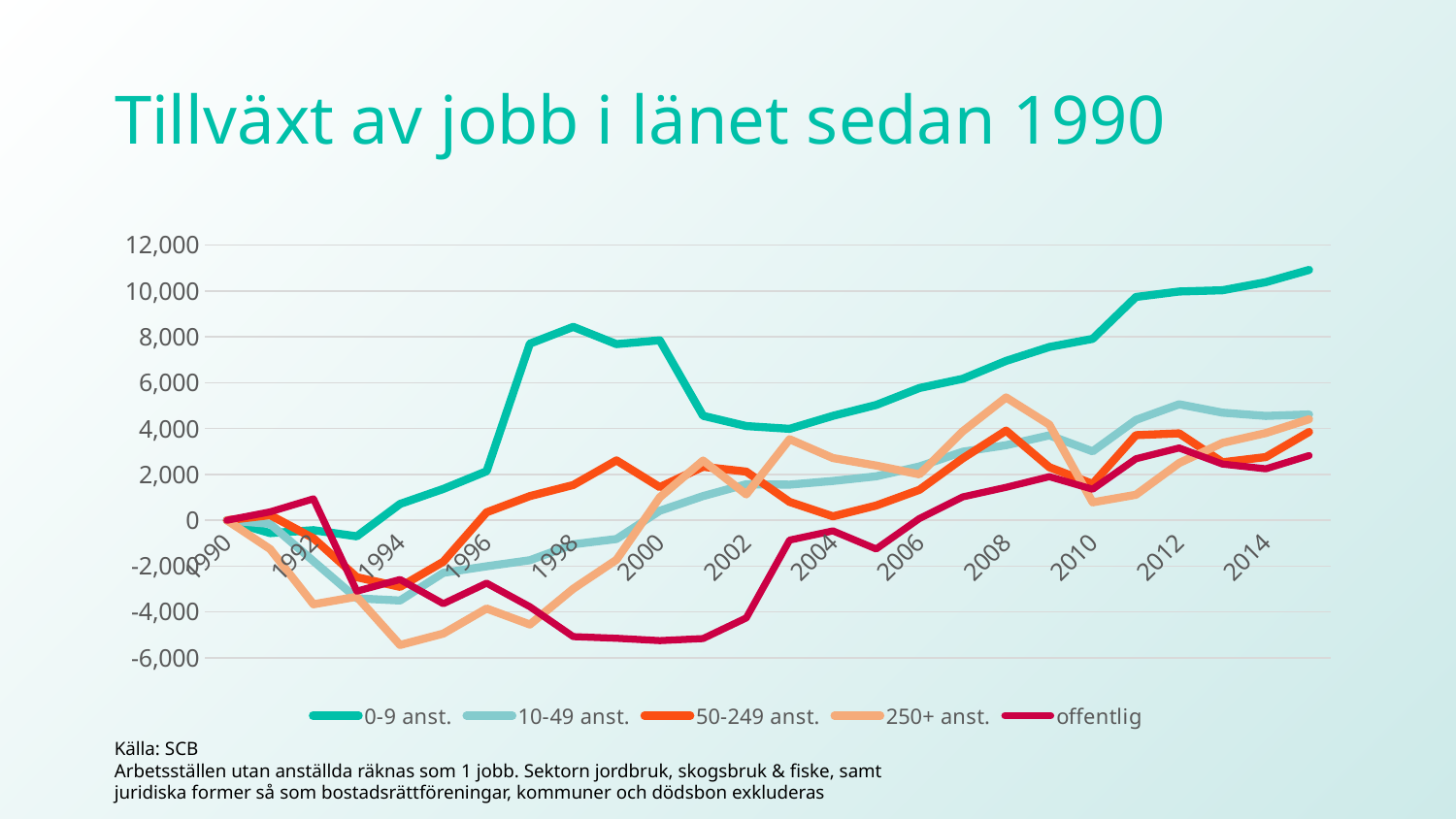
Does the 0-9 anst. series rise or fall from 2004 to the end of the chart? rise Which series has the highest value at the end of the chart (2014 onward)? 0-9 anst. What is the title of the chart? Tillväxt av jobb i länet sedan 1990 How many series does the legend list? 5 In 2008, which is higher: 250+ anst. or offentlig? 250+ anst. Is the value for 10-49 anst. in 2012 greater or less than 4,000? greater Which series has the lowest value in 2000? offentlig What source is cited below the chart? SCB Is the value for offentlig in 2000 greater or less than -4,000? less What kind of chart is shown on the slide? line chart Which series has the lowest value in 1994? 250+ anst. Is the value for 0-9 anst. at the last point of the series greater or less than 10,000? greater